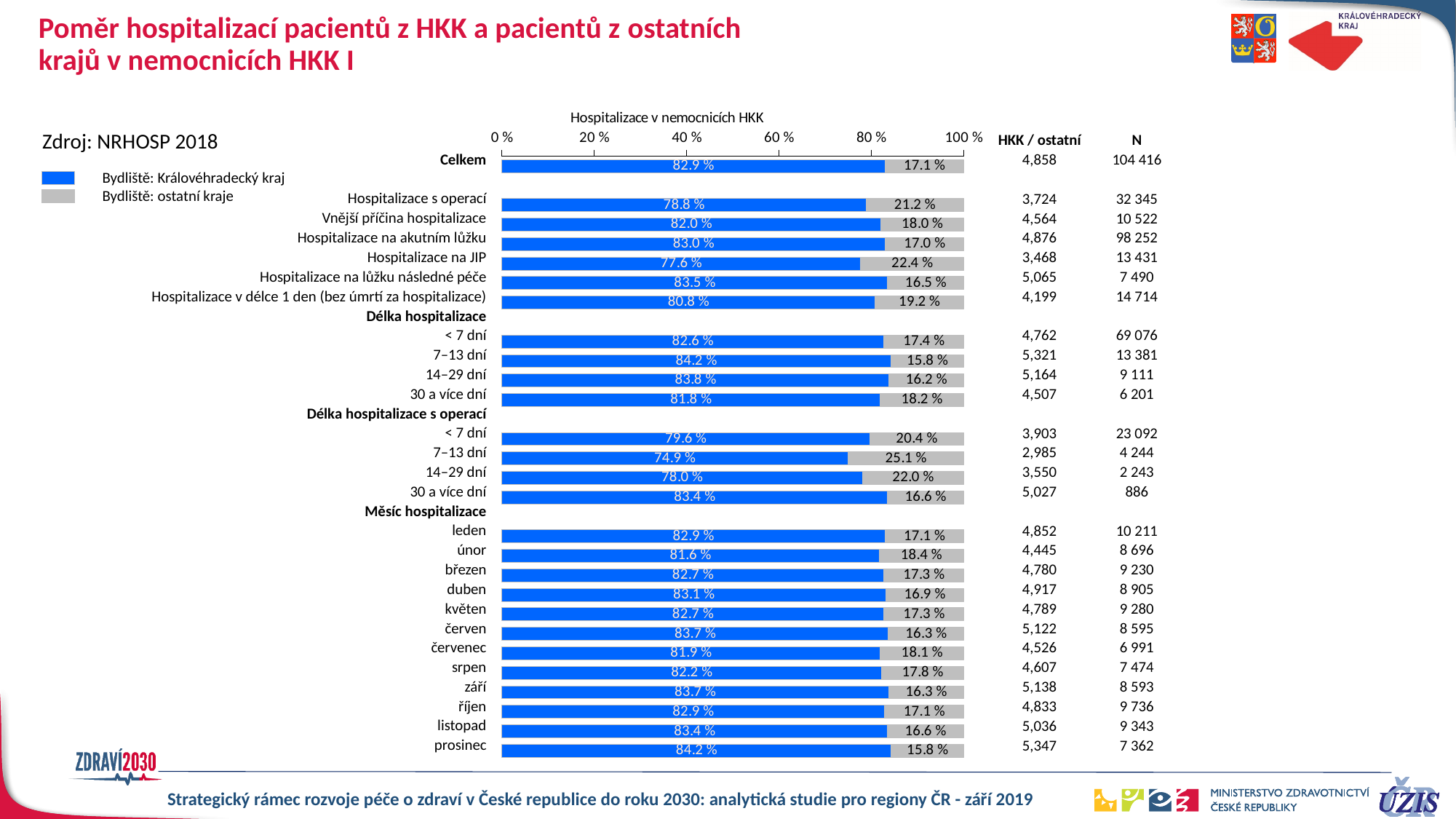
Which has a larger Bydliště: Královéhradecký kraj share: Hospitalizace na JIP or Hospitalizace na lůžku následné péče? Hospitalizace na lůžku následné péče How many series does the legend list? 2 What kind of chart is shown on the slide? Stacked horizontal bar chart What is the title shown above the chart's percentage axis? Hospitalizace v nemocnicích HKK Among the months in the Měsíc hospitalizace section, which month has the lowest Bydliště: Královéhradecký kraj share? únor What is the difference between the Bydliště: Královéhradecký kraj value for Celkem and for Hospitalizace na JIP? 5.3 percentage points Which bar on the chart has the lowest Bydliště: Královéhradecký kraj share overall? 7–13 dní (Délka hospitalizace s operací) In the Délka hospitalizace s operací section, what is the Bydliště: ostatní kraje value for 7–13 dní? 25.1 % Among the months in the Měsíc hospitalizace section, which month has the highest Bydliště: Královéhradecký kraj share? prosinec What is the value for Bydliště: ostatní kraje in the Hospitalizace na JIP bar? 22.4 % What is the value for Bydliště: Královéhradecký kraj in the Celkem bar? 82.9 % How many months are plotted in the Měsíc hospitalizace section? 12